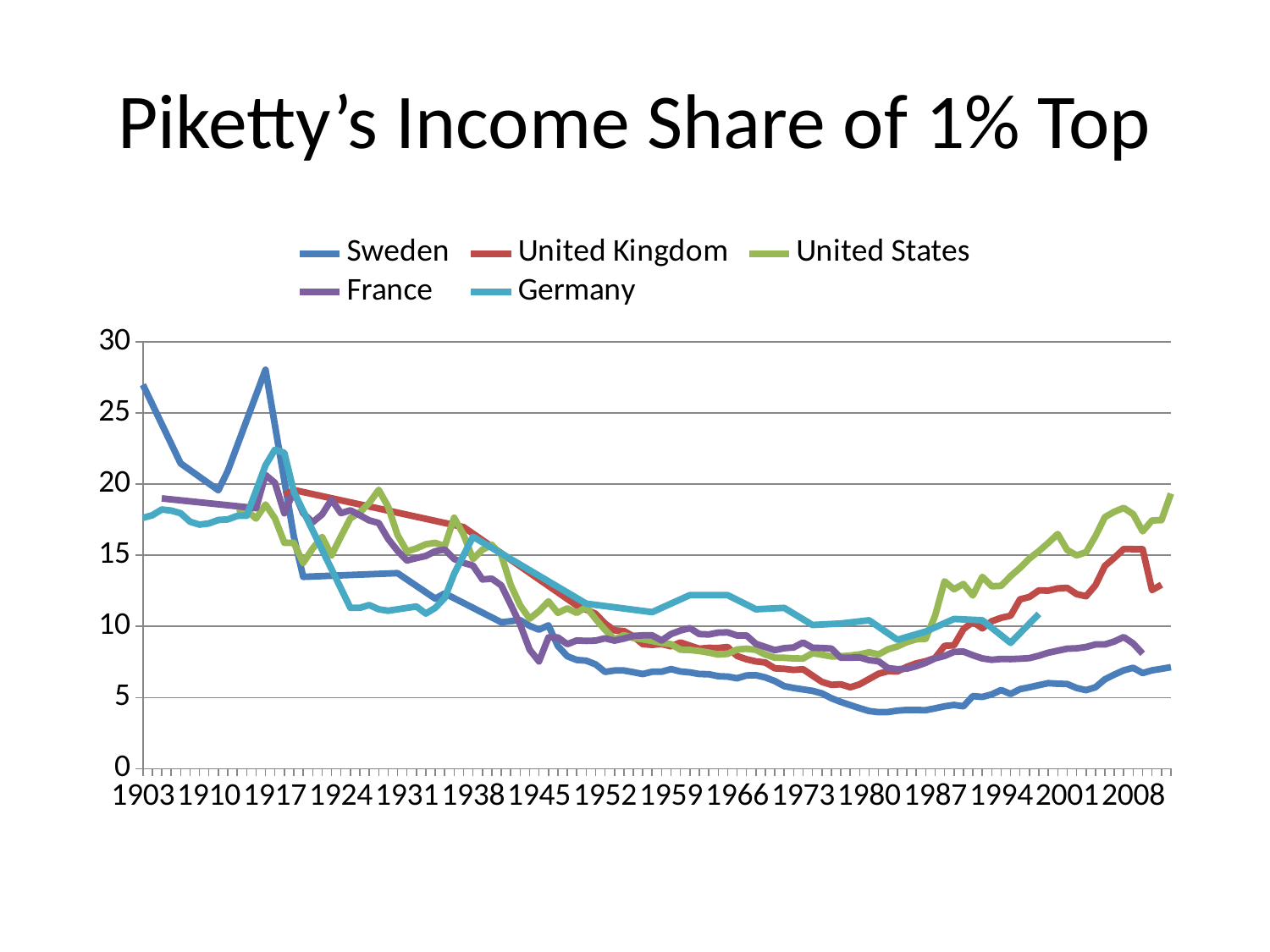
Which series has the highest value at the right end of the chart, around 2008? United States Does the Sweden series rise or fall overall between 1903 and 1980? fall Is the value for Sweden around 1980 greater or less than 5? less What kind of chart is shown on the slide? line chart How many series does the legend list? 5 What is the title of the chart? Piketty's Income Share of 1% Top Which series has the highest value in 1903? Sweden Is the value for the United States around 2008 greater or less than 15? greater Which series is drawn in green in the chart? United States Is the value for Sweden in 1903 greater or less than 25? greater Which series has the lowest value around 1980? Sweden Which is larger in 1903, the value for Sweden or the value for Germany? Sweden